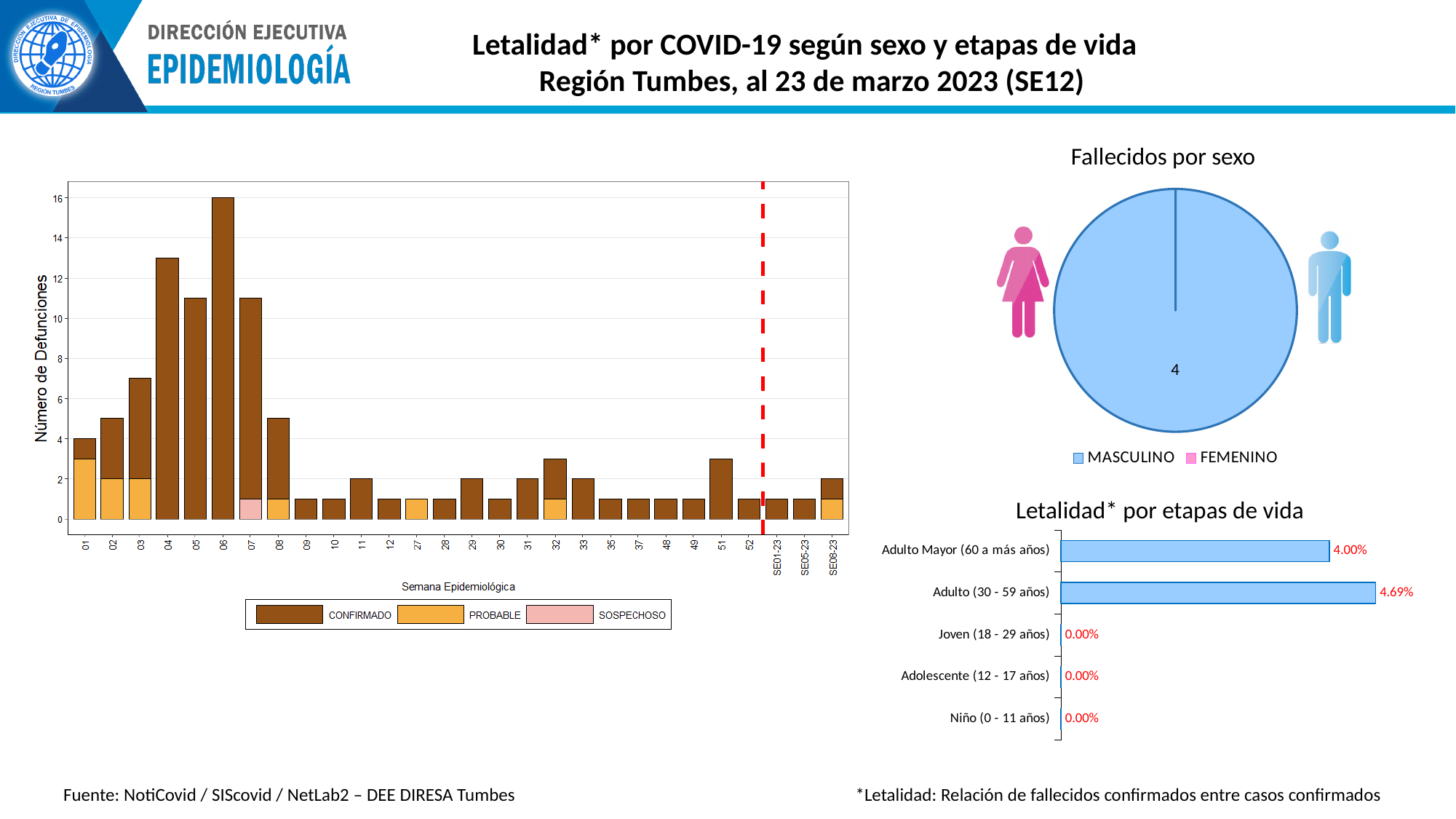
In the 'Letalidad* por etapas de vida' chart, what is the value for Adulto Mayor (60 a más años)? 4.00% What kind of chart is the 'Letalidad* por etapas de vida' chart? Bar chart In the 'Letalidad* por etapas de vida' chart, how many age groups are shown? 5 How many series does the legend of the 'Número de Defunciones' chart on the left list? 3 In the 'Fallecidos por sexo' pie chart, what value is shown for MASCULINO? 4 In the 'Letalidad* por etapas de vida' chart, which age group has the highest value? Adulto (30 - 59 años) In the 'Letalidad* por etapas de vida' chart, what is the value for Adulto (30 - 59 años)? 4.69% In the 'Número de Defunciones' chart on the left, is the value for week 04 greater or less than 12? greater How many entries does the legend of the 'Fallecidos por sexo' pie chart list? 2 In the 'Letalidad* por etapas de vida' chart, what is the value for Joven (18 - 29 años)? 0.00% In the 'Número de Defunciones' chart on the left, which epidemiological week has the highest number of deaths? 06 In the 'Letalidad* por etapas de vida' chart, what is the difference between the values for Adulto (30 - 59 años) and Adulto Mayor (60 a más años)? 0.69%